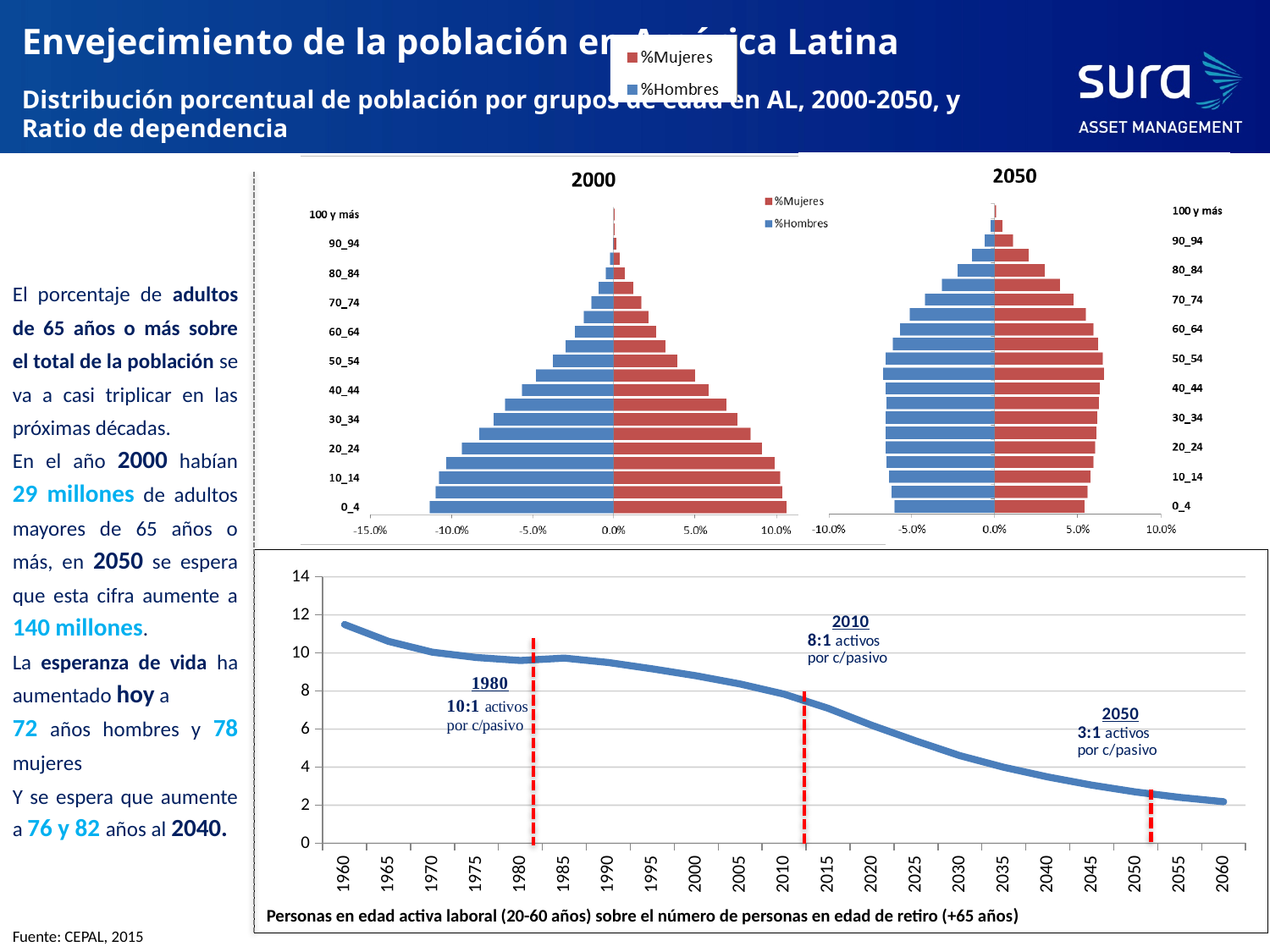
In the 2000 population pyramid, which age group has the largest share of the population? 0_4 In the bottom line chart, according to the annotation, how many active workers per retiree are expected in 2050? 3:1 In the bottom line chart, according to the annotation, how many active workers per retiree were there in 1980? 10:1 In the bottom line chart, is the value for 1960 greater or less than 10? greater What kind of chart is the bottom chart showing the ratio of working-age people to retirees from 1960 to 2060? Line chart In the bottom line chart, does the ratio rise or fall from 1960 to 2060? Fall In the population pyramid charts, which series is shown in red? %Mujeres In the 2050 population pyramid, is the %Mujeres value for the 0_4 age group greater or less than 10.0%? less In the bottom line chart, according to the annotation, how many active workers per retiree were there in 2010? 8:1 In the bottom line chart, is the value for 2060 greater or less than 4? less How many series does the legend of the population pyramid charts list? 2 What kind of chart are the 2000 and 2050 population pyramids at the top of the slide? Bar chart